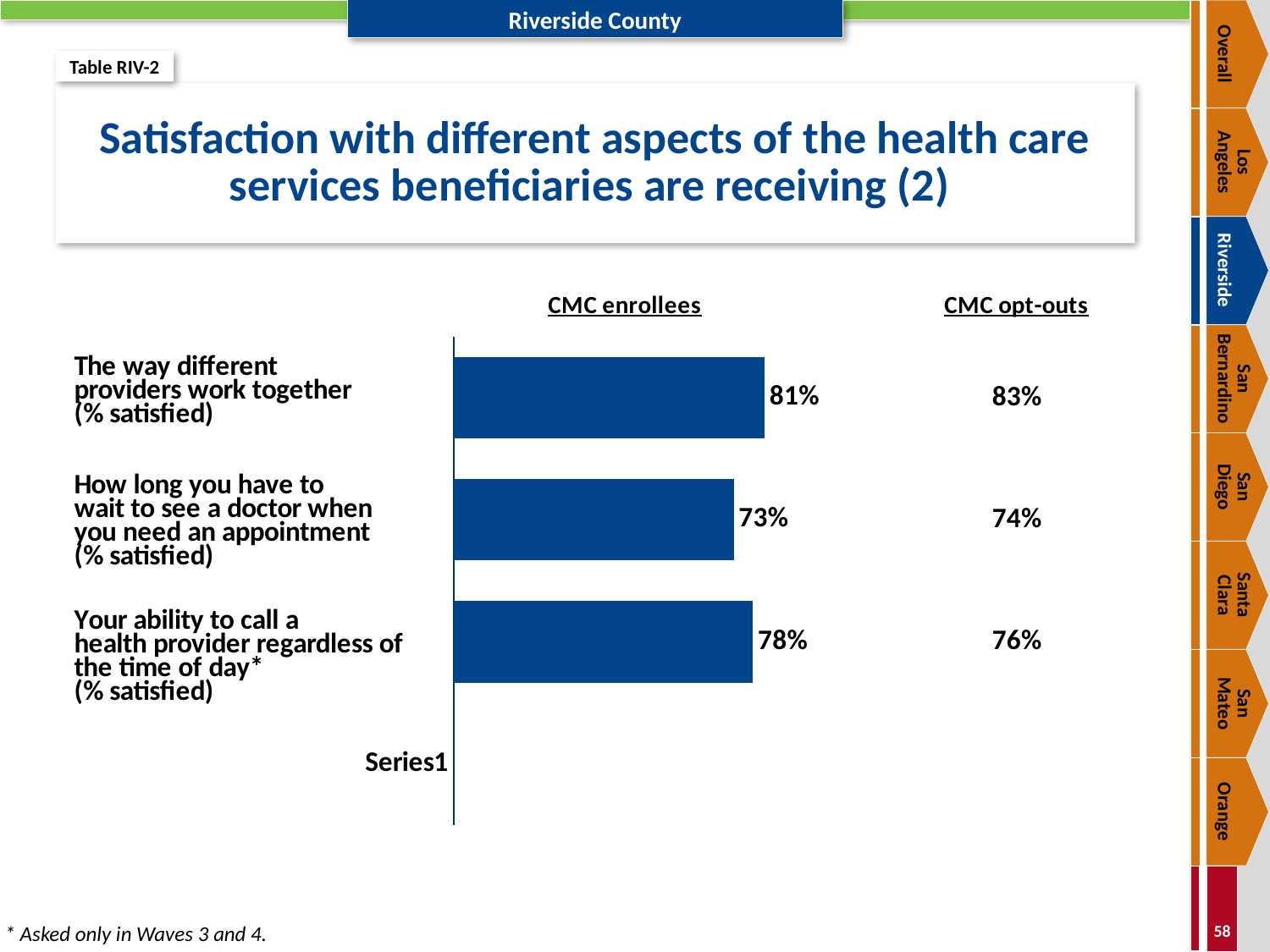
What is the CMC opt-outs value shown for 'Your ability to call a health provider regardless of the time of day (% satisfied)'? 76% What is the title of the chart on the slide? Satisfaction with different aspects of the health care services beneficiaries are receiving (2) How many categories are plotted as bars in the chart? 3 What is the CMC opt-outs value shown for 'The way different providers work together (% satisfied)'? 83% What kind of chart is shown on the slide? Bar chart Which category has the lowest CMC enrollees value? How long you have to wait to see a doctor when you need an appointment (% satisfied) What is the CMC enrollees value for 'Your ability to call a health provider regardless of the time of day (% satisfied)'? 78% What is the CMC enrollees value for 'The way different providers work together (% satisfied)'? 81% What is the CMC enrollees value for 'How long you have to wait to see a doctor when you need an appointment (% satisfied)'? 73% Which is larger for CMC enrollees: 'Your ability to call a health provider regardless of the time of day' or 'How long you have to wait to see a doctor when you need an appointment'? Your ability to call a health provider regardless of the time of day Which category has the highest CMC enrollees value? The way different providers work together (% satisfied) What is the difference between the CMC enrollees values for 'The way different providers work together' and 'How long you have to wait to see a doctor when you need an appointment'? 8%